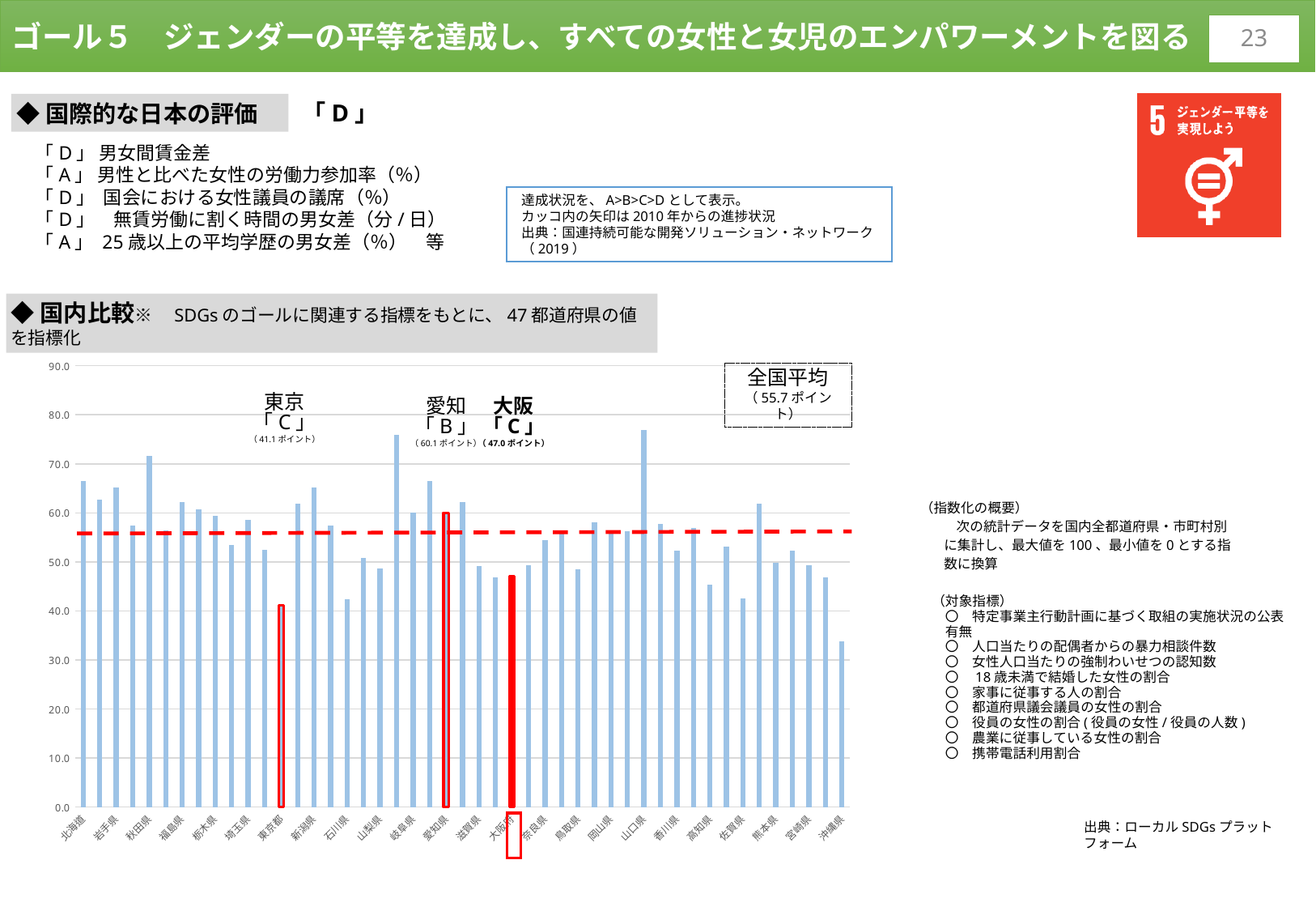
What kind of chart is used for the 国内比較? bar chart What is the value for 大阪府 in the 国内比較 bar chart? 47.0 ポイント Which prefecture has the lowest value in the chart? 沖縄県 Which has the larger value, 東京都 or 大阪府? 大阪府 What is the value for 東京都 in the 国内比較 bar chart? 41.1 ポイント What is the 全国平均 value shown on the chart? 55.7 ポイント What does the red dashed horizontal line on the chart represent? 全国平均（55.7 ポイント） What is the difference between the values for 愛知県 and 東京都? 19.0 ポイント What is the difference between the values for 愛知県 and 大阪府? 13.1 ポイント Is the value for 沖縄県 greater or less than 40.0? less What is the value for 愛知県 in the 国内比較 bar chart? 60.1 ポイント Is the value for 北海道 greater or less than 60.0? greater